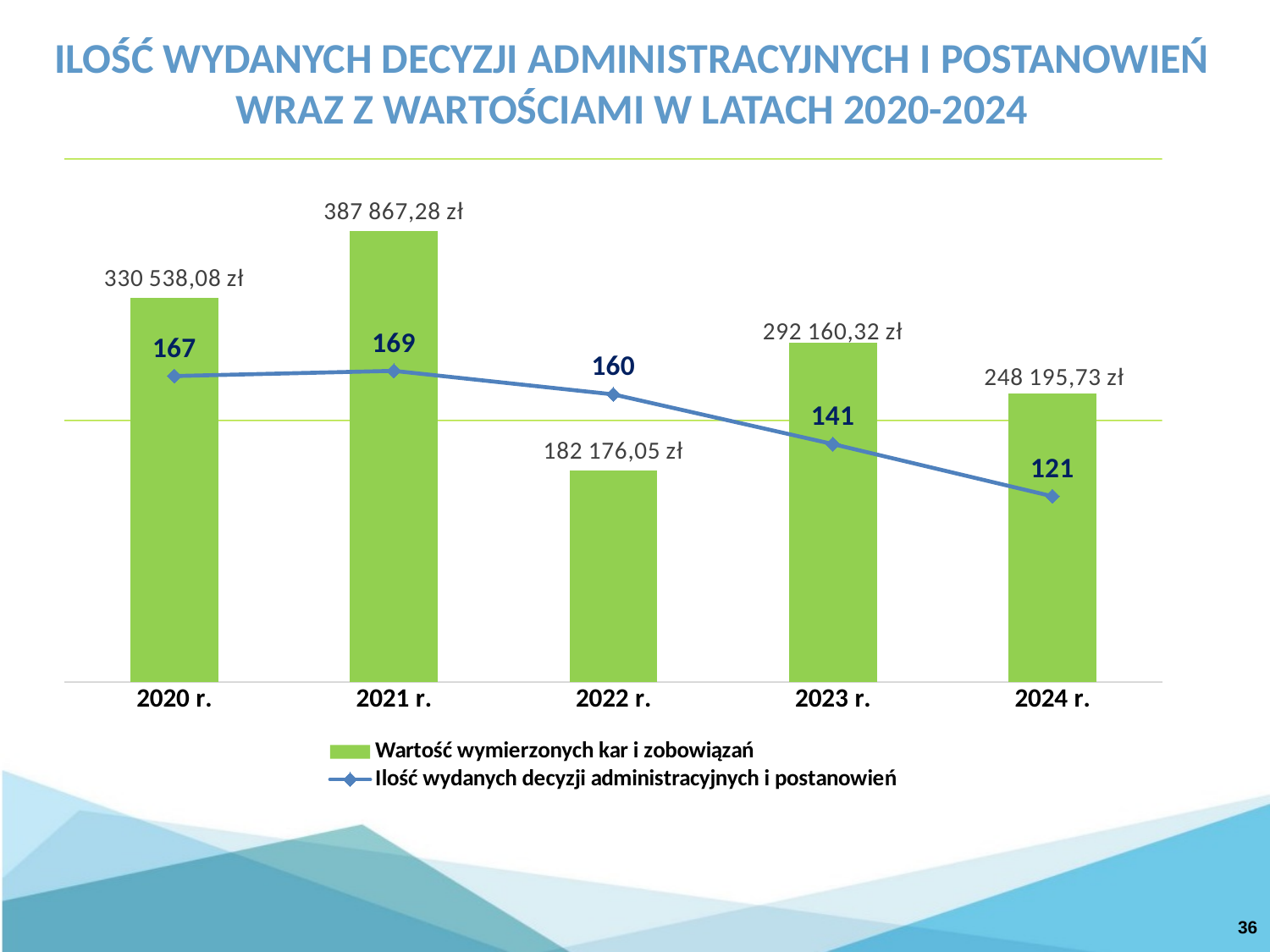
Which year has the lowest value of 'Ilość wydanych decyzji administracyjnych i postanowień'? 2024 r. What is the difference between the 'Wartość wymierzonych kar i zobowiązań' values for 2021 r. and 2022 r.? 205 691,23 zł What is the value of 'Wartość wymierzonych kar i zobowiązań' for 2021 r.? 387 867,28 zł What is the difference between the 'Ilość wydanych decyzji administracyjnych i postanowień' values for 2021 r. and 2024 r.? 48 How many series does the legend list? 2 Which year has the lowest value of 'Wartość wymierzonych kar i zobowiązań'? 2022 r. Does the 'Ilość wydanych decyzji administracyjnych i postanowień' line rise or fall from 2021 r. to 2024 r.? fall Which year has the highest value of 'Wartość wymierzonych kar i zobowiązań'? 2021 r. What is the value of 'Ilość wydanych decyzji administracyjnych i postanowień' for 2023 r.? 141 What is the value of 'Wartość wymierzonych kar i zobowiązań' for 2024 r.? 248 195,73 zł How many years are shown on the x axis of the chart? 5 Which year has a larger 'Wartość wymierzonych kar i zobowiązań': 2020 r. or 2023 r.? 2020 r.